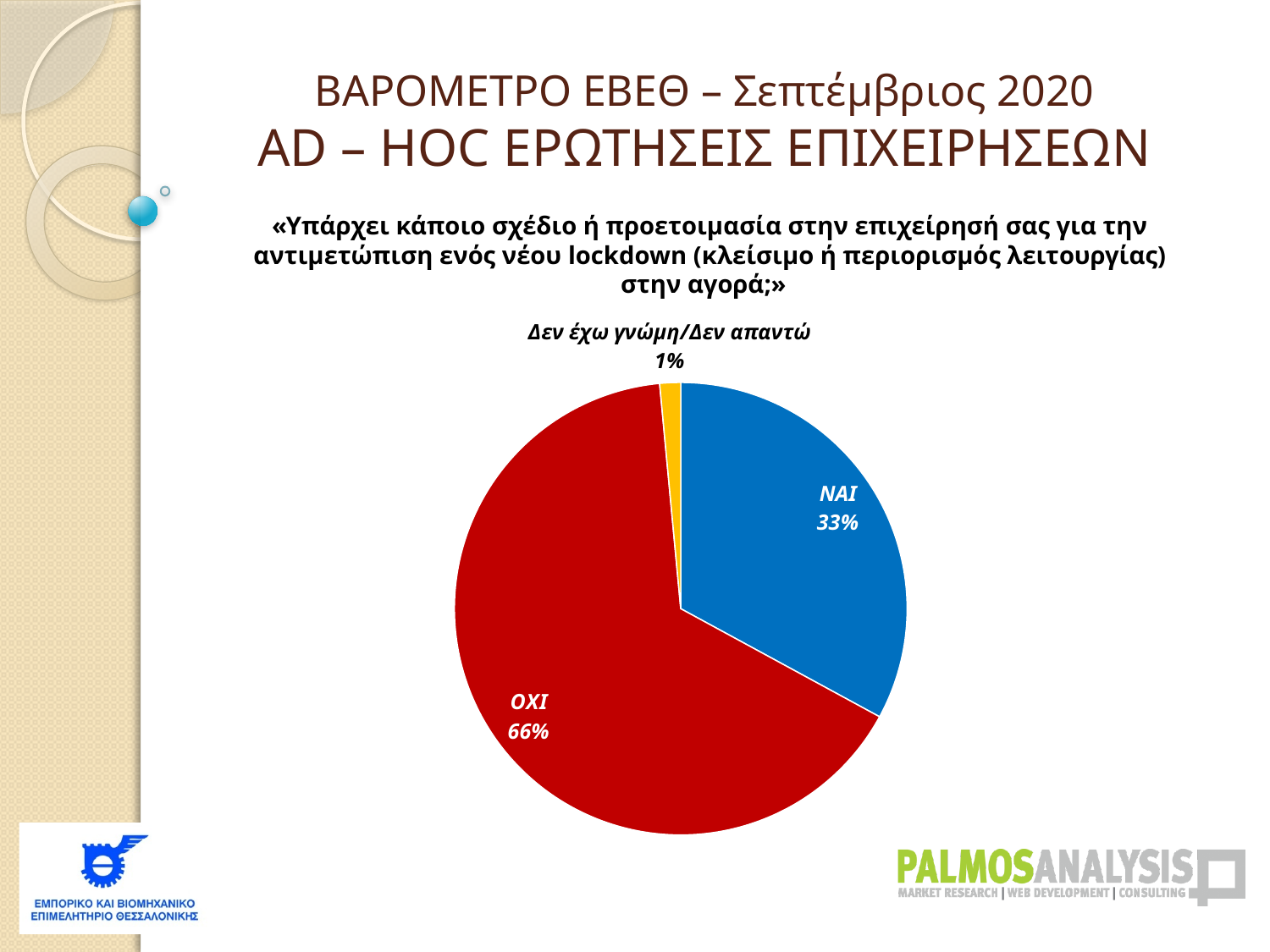
Which slice of the pie chart is the largest? ΟΧΙ What kind of chart is shown on the slide? pie chart What percentage of the pie chart is labelled ΟΧΙ? 66% What percentage of the pie chart is labelled Δεν έχω γνώμη/Δεν απαντώ? 1% What is the difference in percentage points between the ΟΧΙ slice and the ΝΑΙ slice? 33 Which slice of the pie chart is the smallest? Δεν έχω γνώμη/Δεν απαντώ What colour is the ΝΑΙ slice of the pie chart? blue How many slices does the pie chart have? 3 What percentage of the pie chart is labelled ΝΑΙ? 33% Which is larger, the ΝΑΙ slice or the ΟΧΙ slice? ΟΧΙ What colour is the ΟΧΙ slice of the pie chart? red What share of the pie does the ΝΑΙ slice represent? 33%